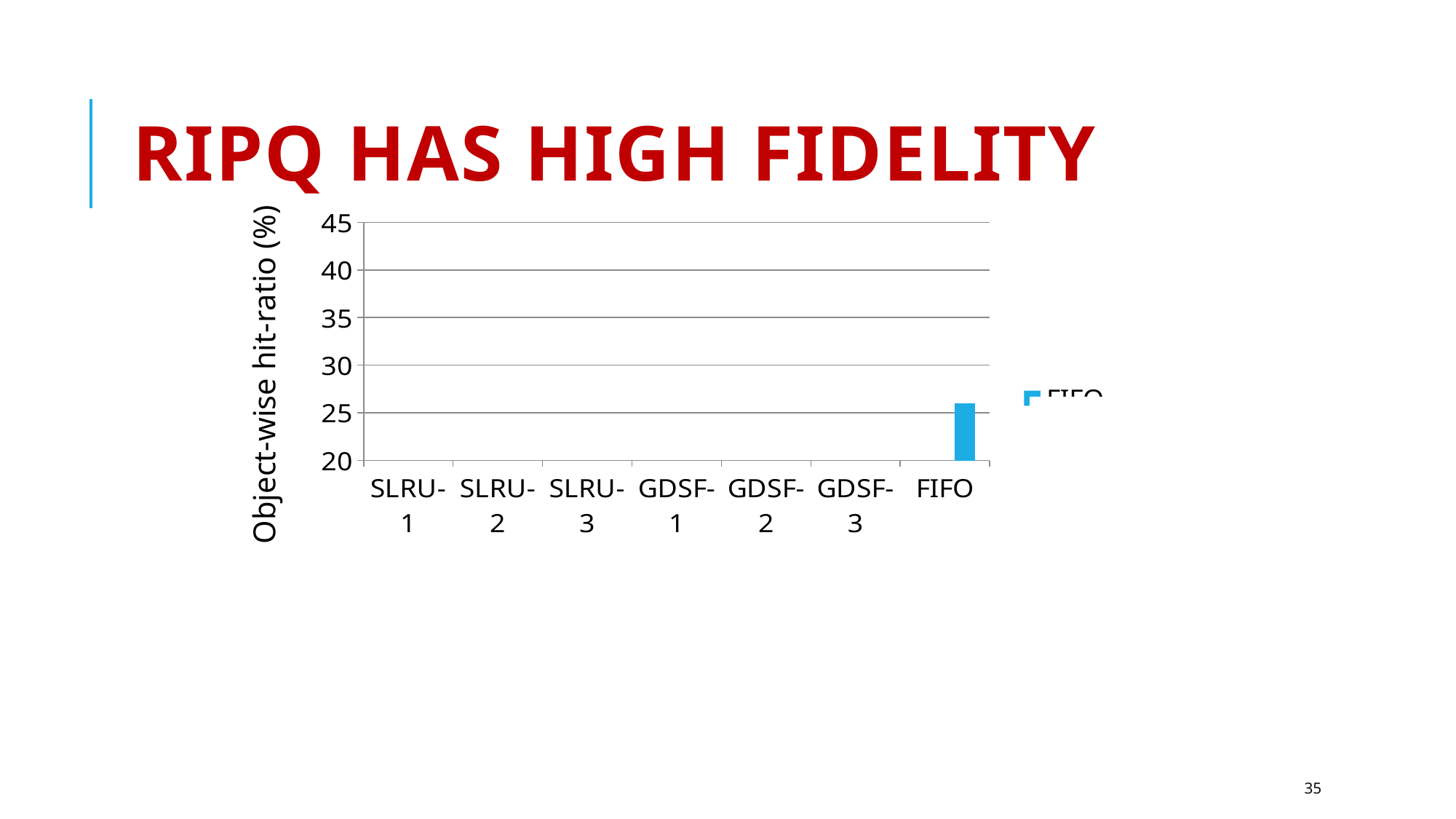
What is the title of the slide containing the chart? RIPQ HAS HIGH FIDELITY How many categories are listed on the x axis of the chart? 7 What is the highest value shown on the y axis of the chart? 45 What is the label of the y axis of the chart? Object-wise hit-ratio (%) Which category has the highest plotted value in the chart? FIFO Is the value for FIFO greater or less than 20? greater Is the value for FIFO greater or less than 30? less What kind of chart is shown on the slide? bar chart